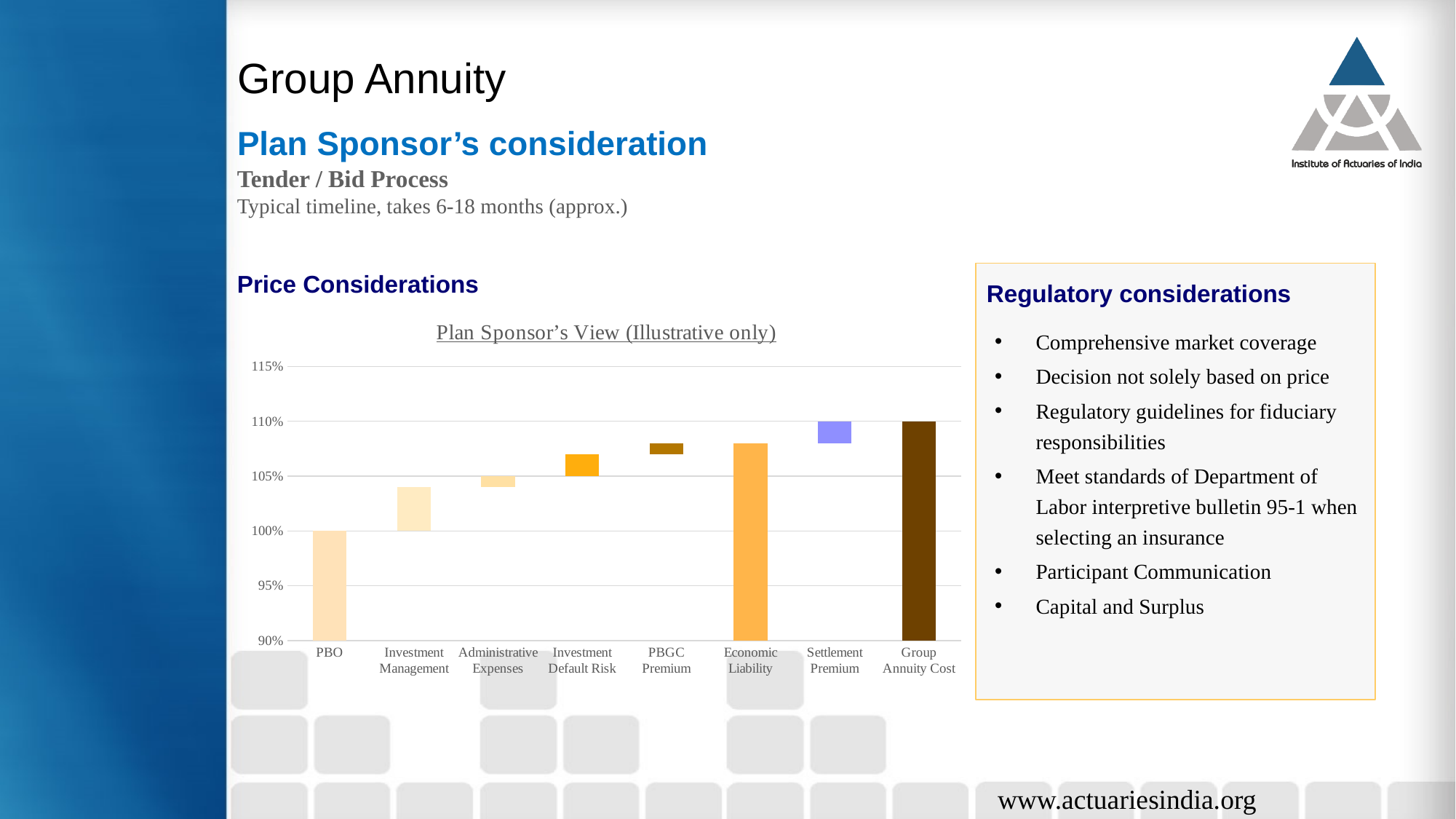
What value does the PBO bar reach? 100% How many categories are shown on the x axis of the chart? 8 What is the title of the chart? Plan Sponsor's View (Illustrative only) Is the top of the Economic Liability bar greater or less than 105%? greater Is the top of the Investment Management bar greater or less than 105%? less Which category has the lowest bar top in the chart? PBO Is the top of the Settlement Premium bar greater or less than 105%? greater Do the bar tops rise or fall moving from PBO to Group Annuity Cost along the x axis? rise What value does the Group Annuity Cost bar reach? 110% Which bar reaches higher, Group Annuity Cost or Economic Liability? Group Annuity Cost What kind of chart is shown under Price Considerations? bar chart